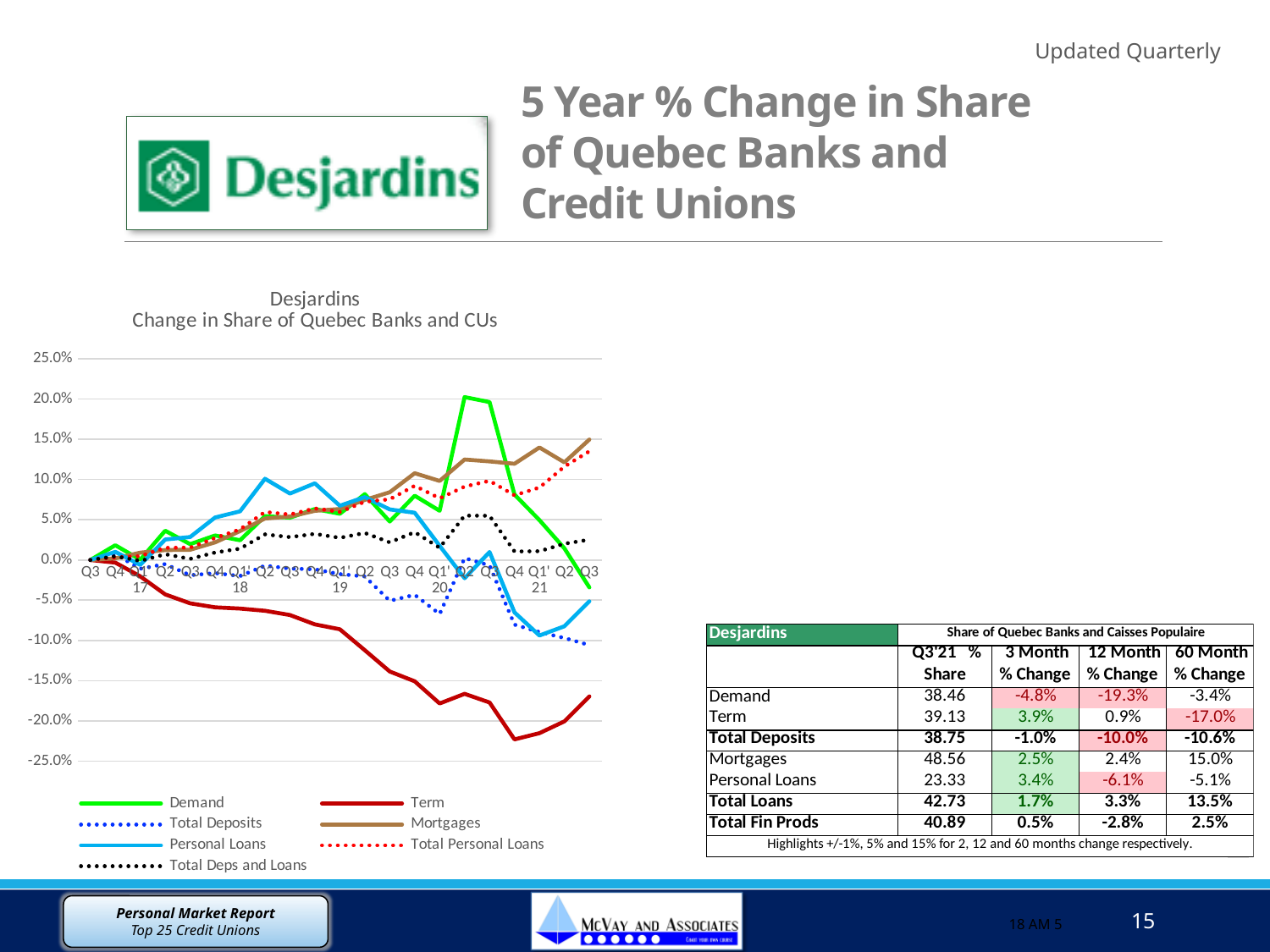
What kind of chart is shown on the slide? line chart Does the Term series rise or fall overall from Q3 16 to Q3 21? fall Is the value for Mortgages at Q3 21 greater or less than 10.0%? greater How many series does the chart legend list? 7 Is the value for Term at Q4 20 greater or less than -20.0%? less Which series has the lowest value at Q3 21? Term Which series is plotted with a solid green line? Demand What is the title of the chart? Desjardins Change in Share of Quebec Banks and CUs Which series reaches the highest value anywhere on the chart? Demand Does the Mortgages series rise or fall overall from Q3 16 to Q3 21? rise Is the value for Demand at Q2 20 greater or less than 15.0%? greater At Q3 21, which is larger, the value for Mortgages or the value for Term? Mortgages